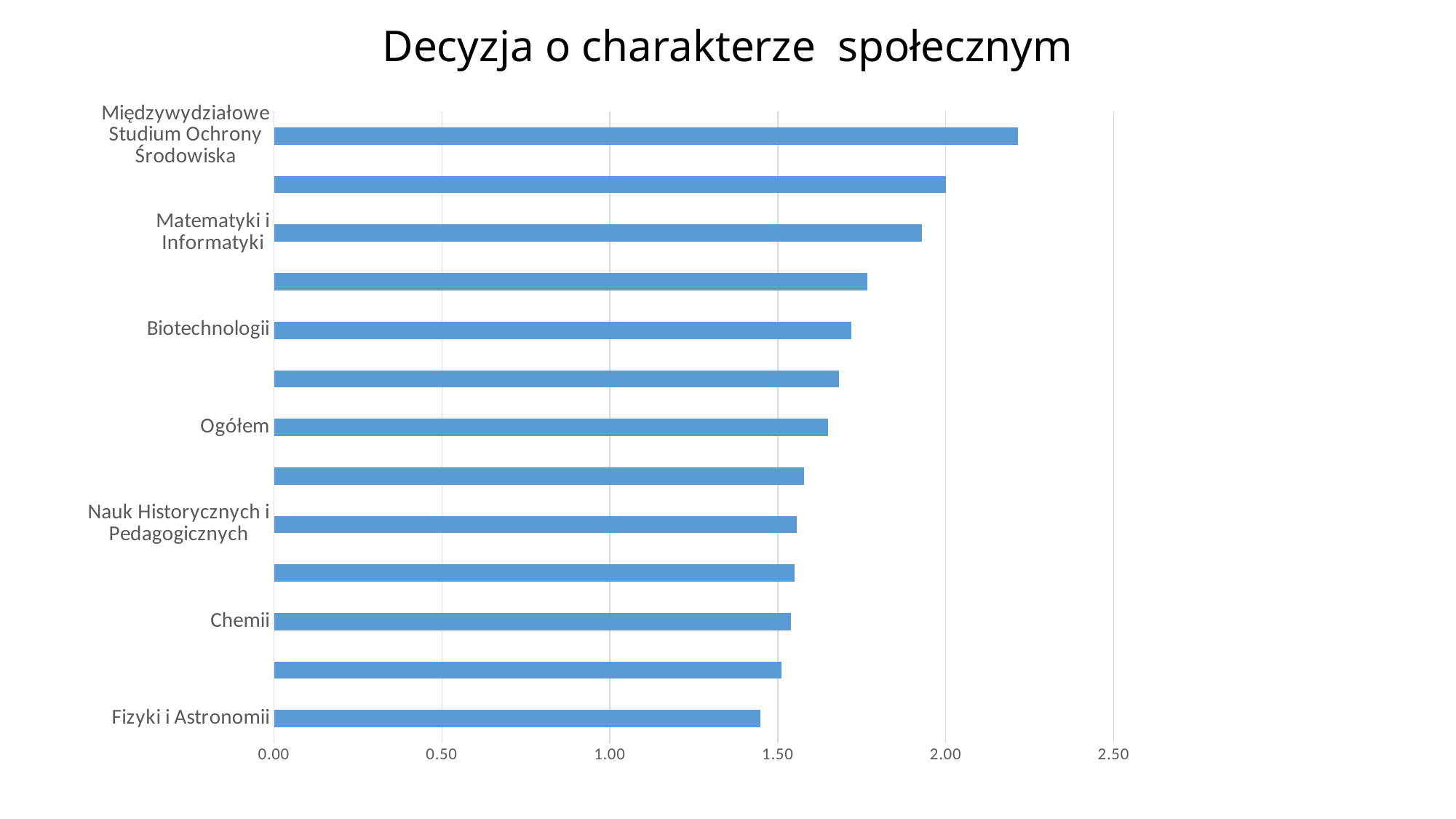
What kind of chart is shown on the slide? bar chart What is the title of the chart? Decyzja o charakterze społecznym Is the value for Międzywydziałowe Studium Ochrony Środowiska greater or less than 2.00? greater Is the value for Ogółem greater or less than 1.50? greater Is the value for Biotechnologii greater or less than 1.50? greater How many bars are plotted in the chart? 13 Which is larger, the value for Ogółem or the value for Fizyki i Astronomii? Ogółem Which is larger, the value for Matematyki i Informatyki or the value for Biotechnologii? Matematyki i Informatyki Which category has the highest value? Międzywydziałowe Studium Ochrony Środowiska Which category has the lowest value? Fizyki i Astronomii